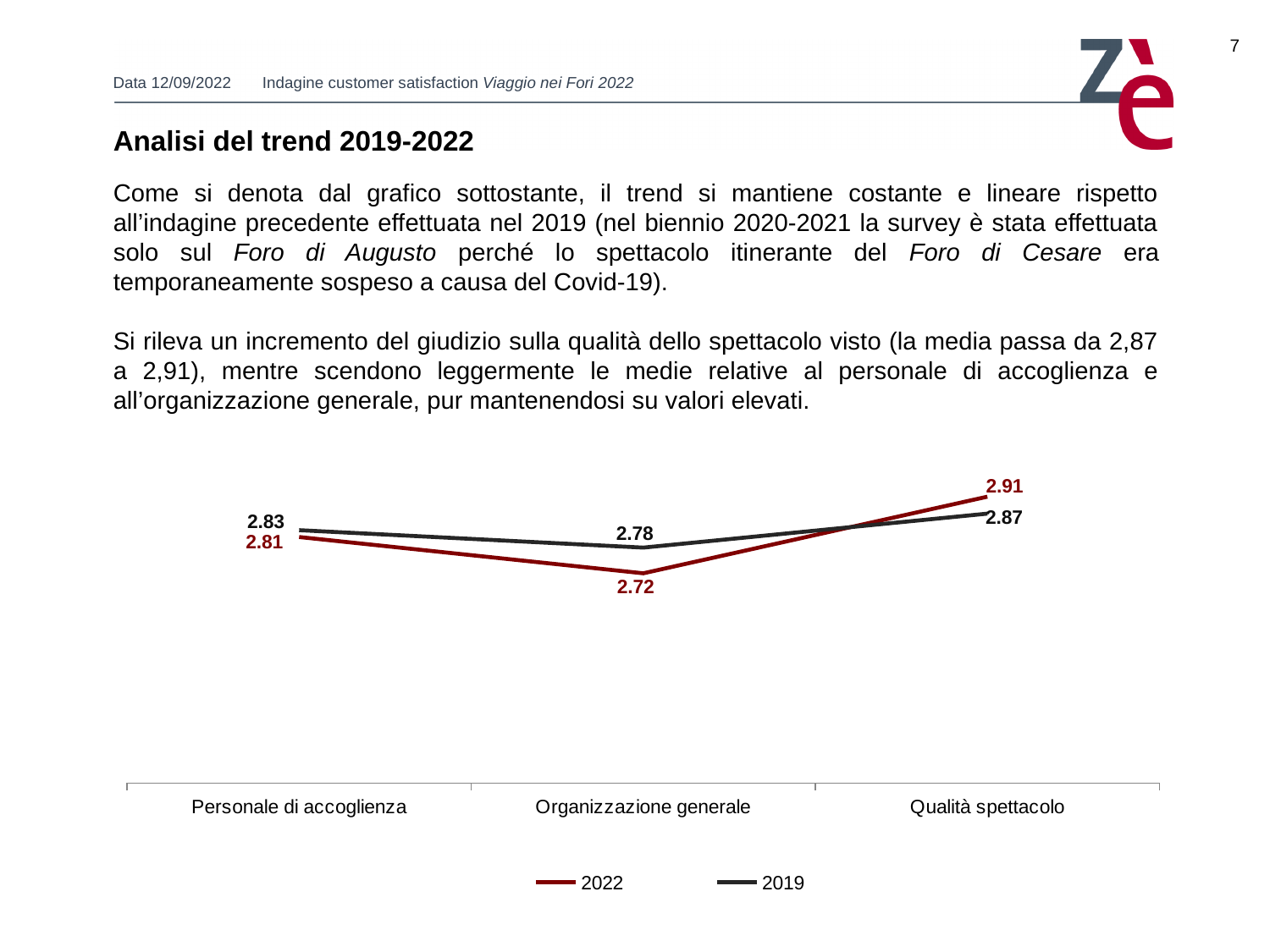
What kind of chart is shown on the slide? Line chart What is the 2022 value for Qualità spettacolo? 2.91 What is the difference between the 2019 and 2022 values for Organizzazione generale? 0.06 How many series does the legend list? 2 Which colour is used for the 2022 series? Dark red What is the 2019 value for Organizzazione generale? 2.78 Which category has the highest 2019 value? Qualità spettacolo Which is larger for Personale di accoglienza, the 2022 value or the 2019 value? 2019 Which category has the lowest 2022 value? Organizzazione generale How many categories are shown on the x axis? 3 What is the 2019 value for Qualità spettacolo? 2.87 What is the 2022 value for Personale di accoglienza? 2.81